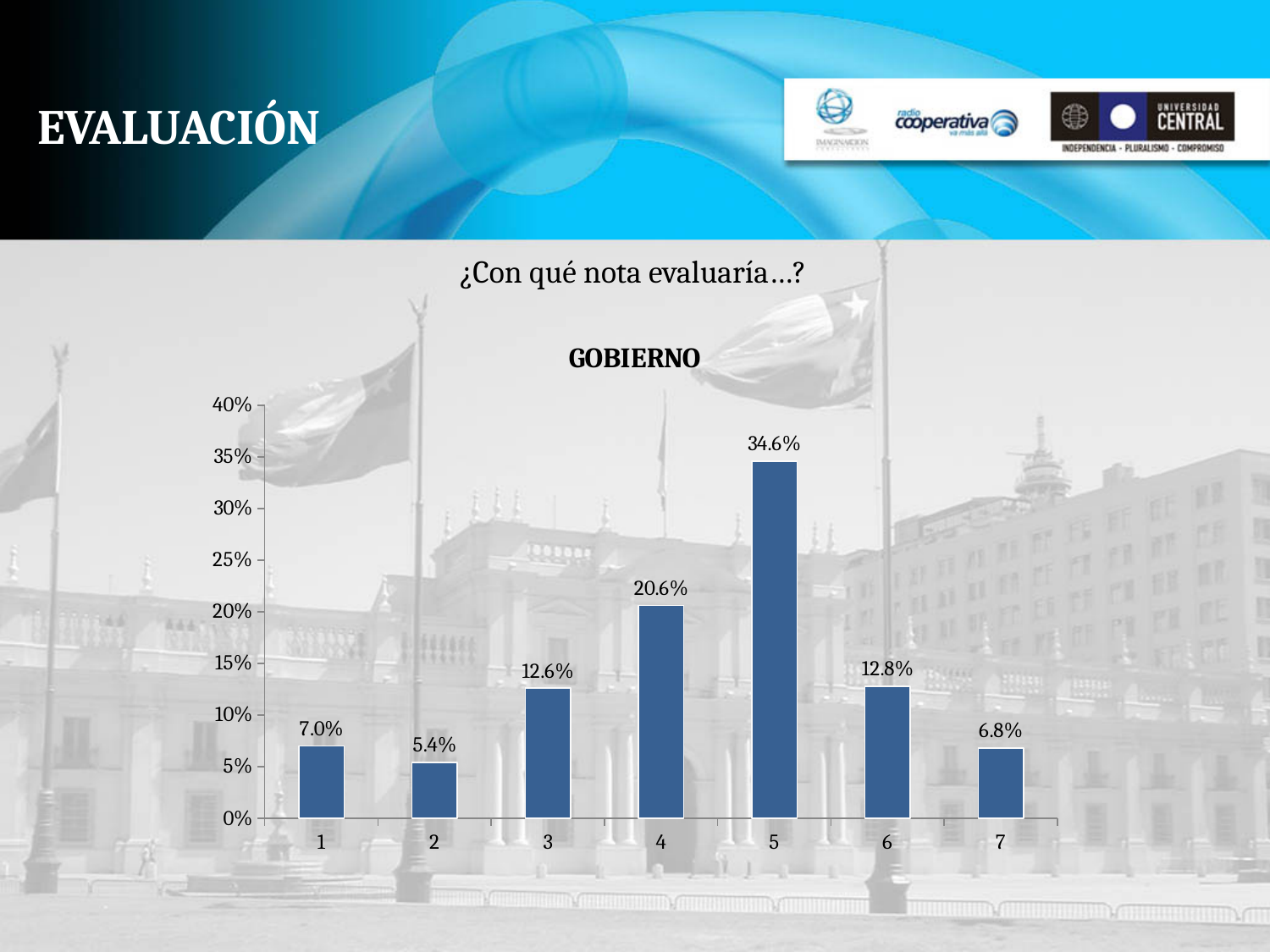
What is the title of the chart on the slide? GOBIERNO What is the value for category 2 in the GOBIERNO chart? 5.4% What is the value for category 5 in the GOBIERNO chart? 34.6% Which category has the highest value in the GOBIERNO chart? 5 What is the value for category 7 in the GOBIERNO chart? 6.8% How many categories are shown on the x axis of the GOBIERNO chart? 7 What kind of chart is the GOBIERNO chart? bar chart Is the value for category 4 in the GOBIERNO chart greater or less than 20%? greater Which is larger in the GOBIERNO chart, the value for category 3 or category 6? 6 Do the values in the GOBIERNO chart rise or fall from category 5 to category 7? fall What is the difference between the values for categories 5 and 4 in the GOBIERNO chart? 14.0% Which category has the lowest value in the GOBIERNO chart? 2